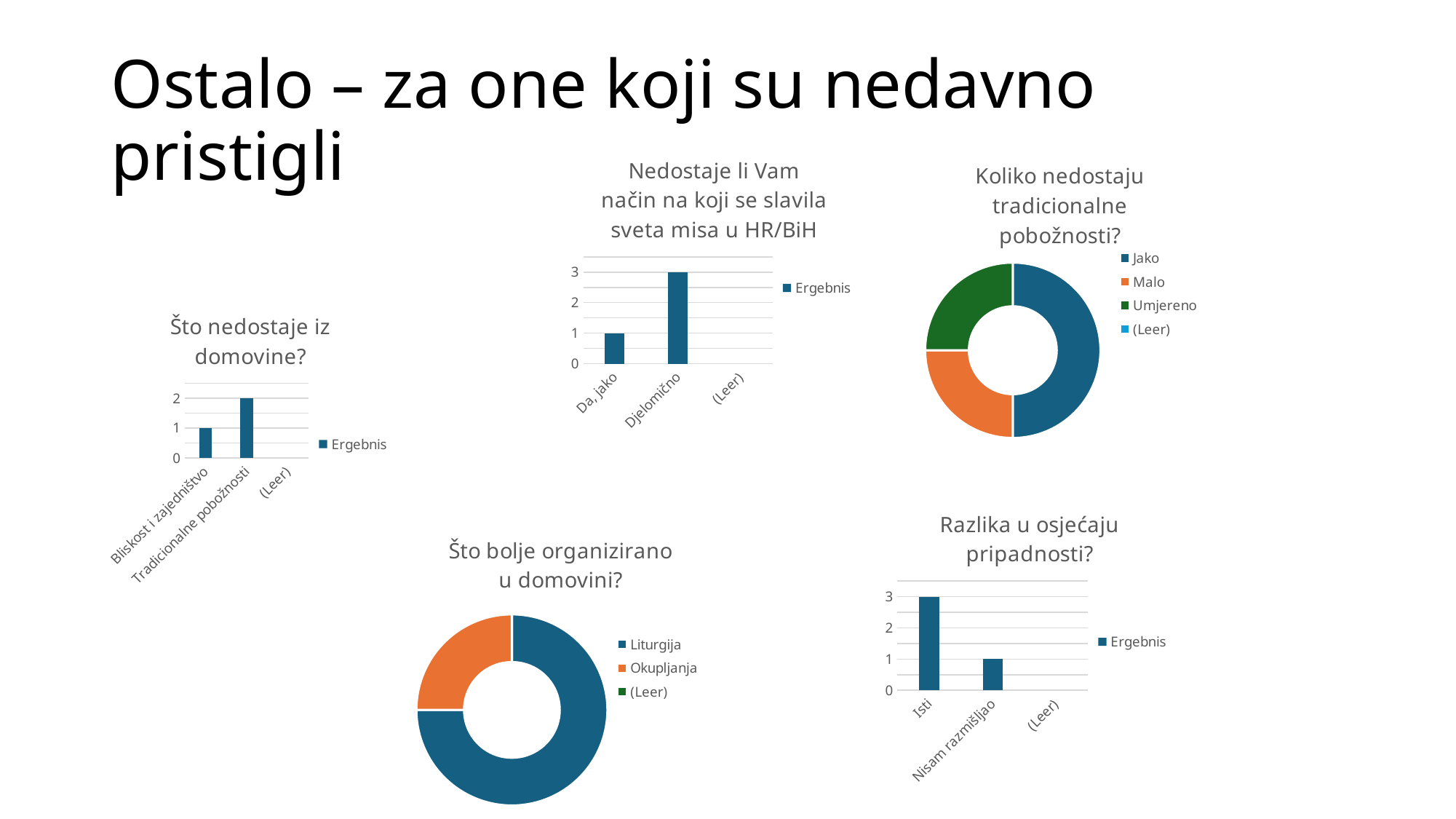
In the chart 'Razlika u osjećaju pripadnosti?', how many categories are shown on the x axis? 3 In the chart 'Što bolje organizirano u domovini?', which is larger, 'Liturgija' or 'Okupljanja'? Liturgija In the chart 'Razlika u osjećaju pripadnosti?', which is larger, 'Isti' or 'Nisam razmišljao'? Isti In the chart 'Što nedostaje iz domovine?', which category has the highest value? Tradicionalne pobožnosti In the chart 'Nedostaje li Vam način na koji se slavila sveta misa u HR/BiH', what is the value for 'Djelomično'? 3 What kind of chart is 'Koliko nedostaju tradicionalne pobožnosti?'? Doughnut chart How many entries does the legend of the chart 'Što bolje organizirano u domovini?' list? 3 In the chart 'Koliko nedostaju tradicionalne pobožnosti?', which category has the largest slice? Jako In the chart 'Nedostaje li Vam način na koji se slavila sveta misa u HR/BiH', what is the difference between 'Djelomično' and 'Da, jako'? 2 In the chart 'Što nedostaje iz domovine?', what is the value for 'Tradicionalne pobožnosti'? 2 In the chart 'Razlika u osjećaju pripadnosti?', what is the value for 'Isti'? 3 What kind of chart is 'Što nedostaje iz domovine?'? Bar chart